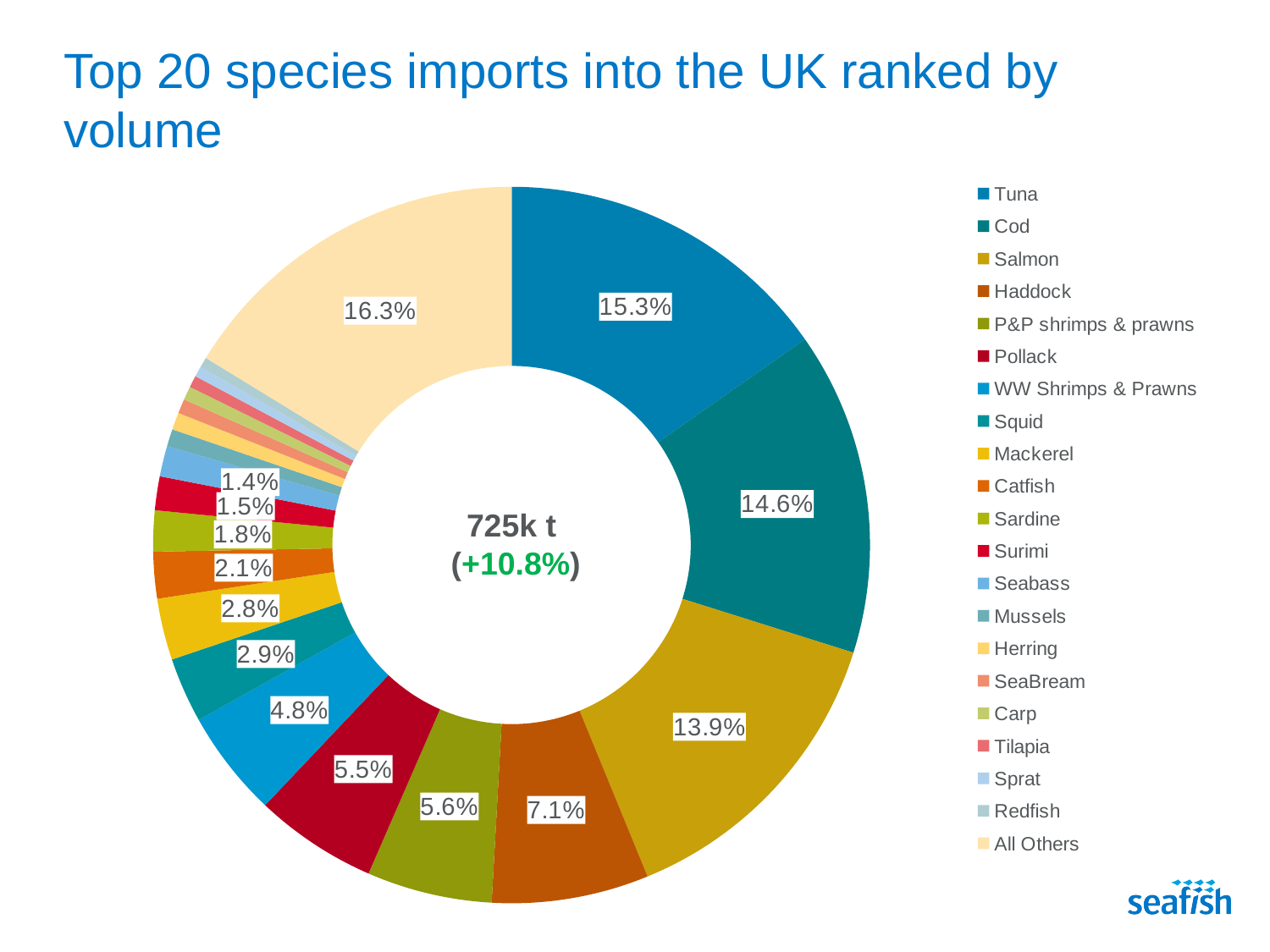
Which slice of the chart is the largest overall? All Others What total volume is shown in the centre of the chart? 725k t What percentage is shown for Haddock? 7.1% What share is shown for Salmon? 13.9% What share is shown for the All Others slice? 16.3% Which has a larger share, Haddock or Pollack? Haddock Which named species has the largest share of imports? Tuna What percentage is shown for Cod? 14.6% What is the difference in percentage points between Tuna and Cod? 0.7% How many entries does the legend list? 21 What kind of chart is shown on the slide? Pie (doughnut) chart What share of UK imports does Tuna account for? 15.3%